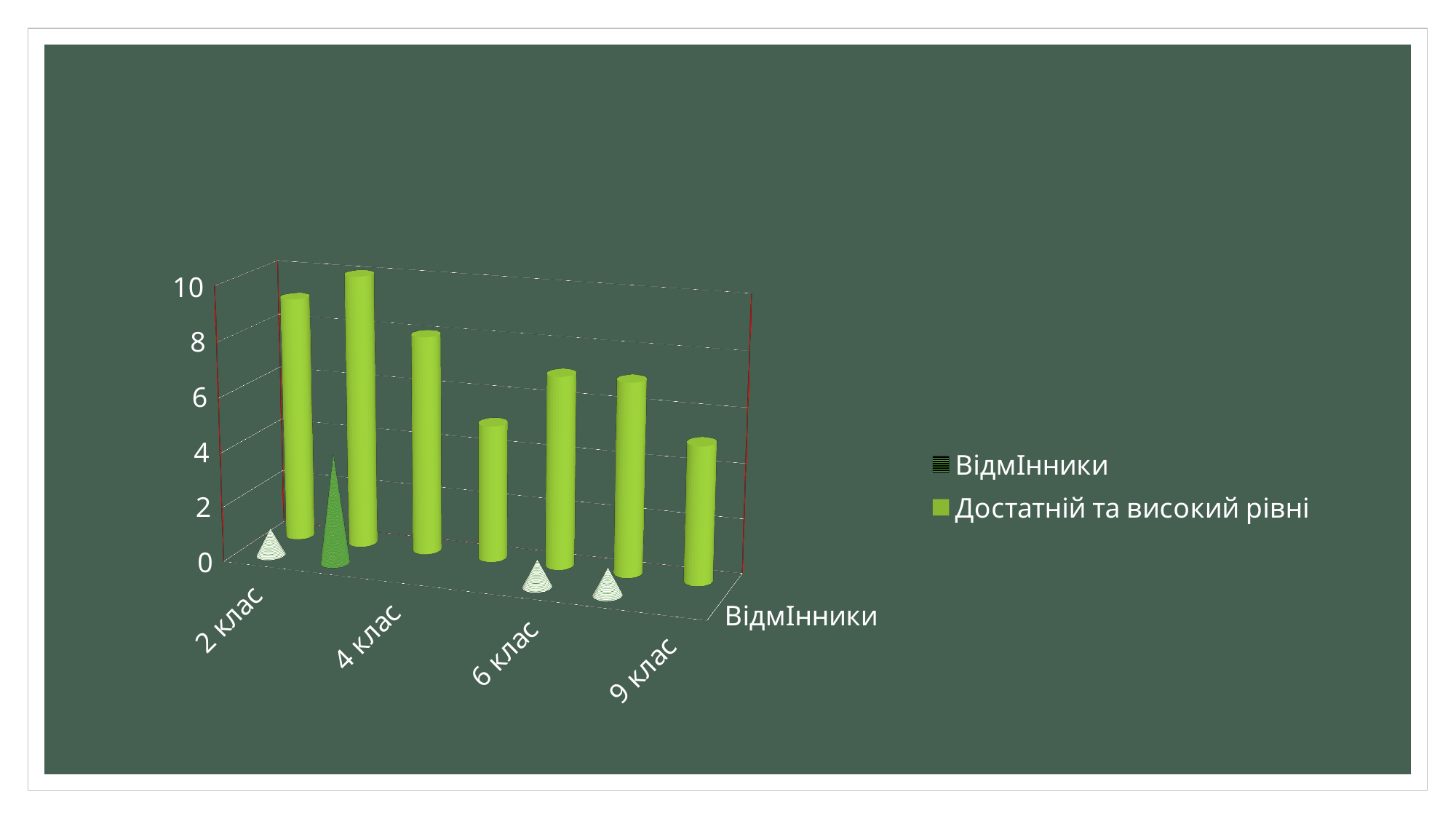
Which is larger for the series Достатній та високий рівні: the value for 4 клас or the value for 9 клас? 4 клас What kind of chart is shown on the slide? bar chart Which series is drawn in green? Достатній та високий рівні What is the highest value shown on the vertical axis? 10 Is the value for 9 клас in the series Достатній та високий рівні greater or less than 8? less Do the values for the series Достатній та високий рівні generally rise or fall from 2 клас to 9 клас? fall How many series does the legend list? 2 What are the two series named in the legend? ВідмІнники; Достатній та високий рівні Which is larger for the series Достатній та високий рівні: the value for 2 клас or the value for 9 клас? 2 клас Is the value for 2 клас in the series Достатній та високий рівні greater or less than 6? greater